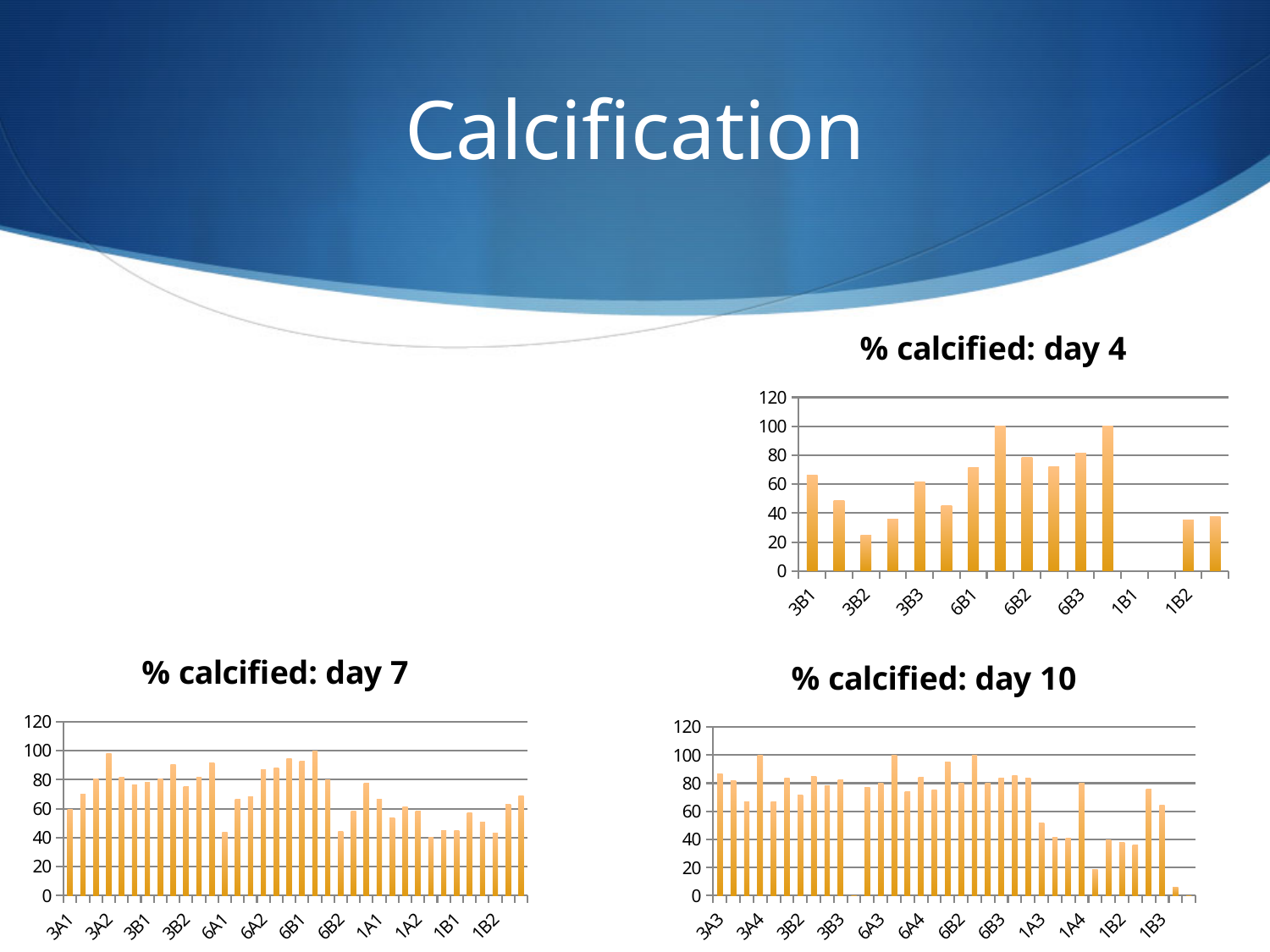
How many charts are shown on the slide? 3 In the "% calcified: day 4" chart, is the value for 6B1 greater or less than 60? greater What kind of chart is the "% calcified: day 4" chart? bar chart In the "% calcified: day 4" chart, which is larger, the value for 6B2 or the value for 3B2? 6B2 In the "% calcified: day 4" chart, is the value for 1B2 greater or less than 60? less In the "% calcified: day 7" chart, which is larger, the value for 6B1 or the value for 6B2? 6B1 In the "% calcified: day 4" chart, is the value for 3B2 greater or less than 40? less What is the title of the chart in the bottom-left of the slide? % calcified: day 7